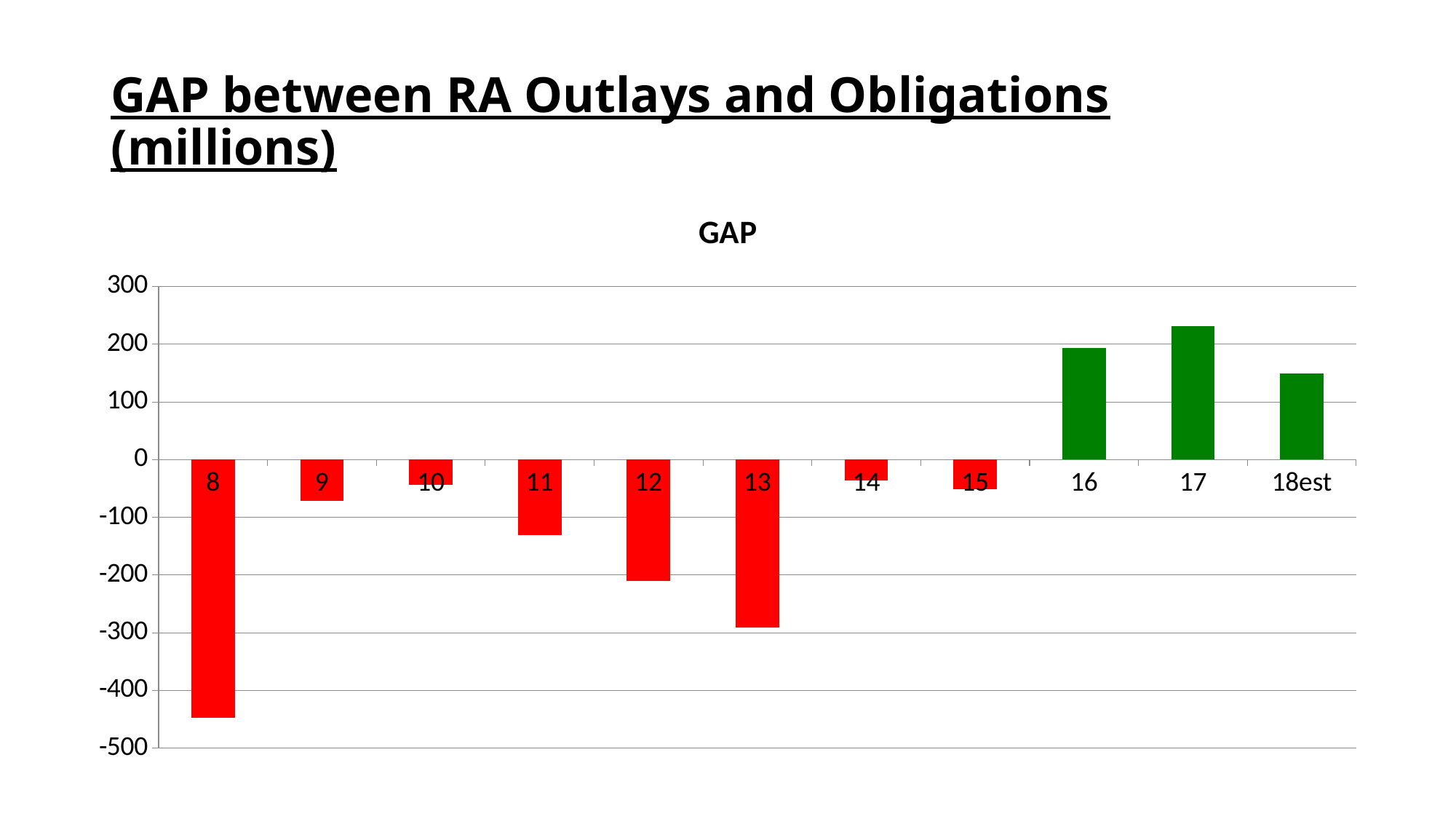
What kind of chart is shown on the slide? bar chart Which has the larger value, 12 or 13? 12 Is the value for 18est greater or less than 100? greater Which category has the lowest value in the GAP chart? 8 Which has the larger value, 16 or 18est? 16 Is the value for 17 greater or less than 200? greater Is the value for 9 greater or less than -100? greater Which category has the highest value in the GAP chart? 17 How many categories are plotted on the x axis of the GAP chart? 11 What colour are the bars for 16, 17 and 18est? green